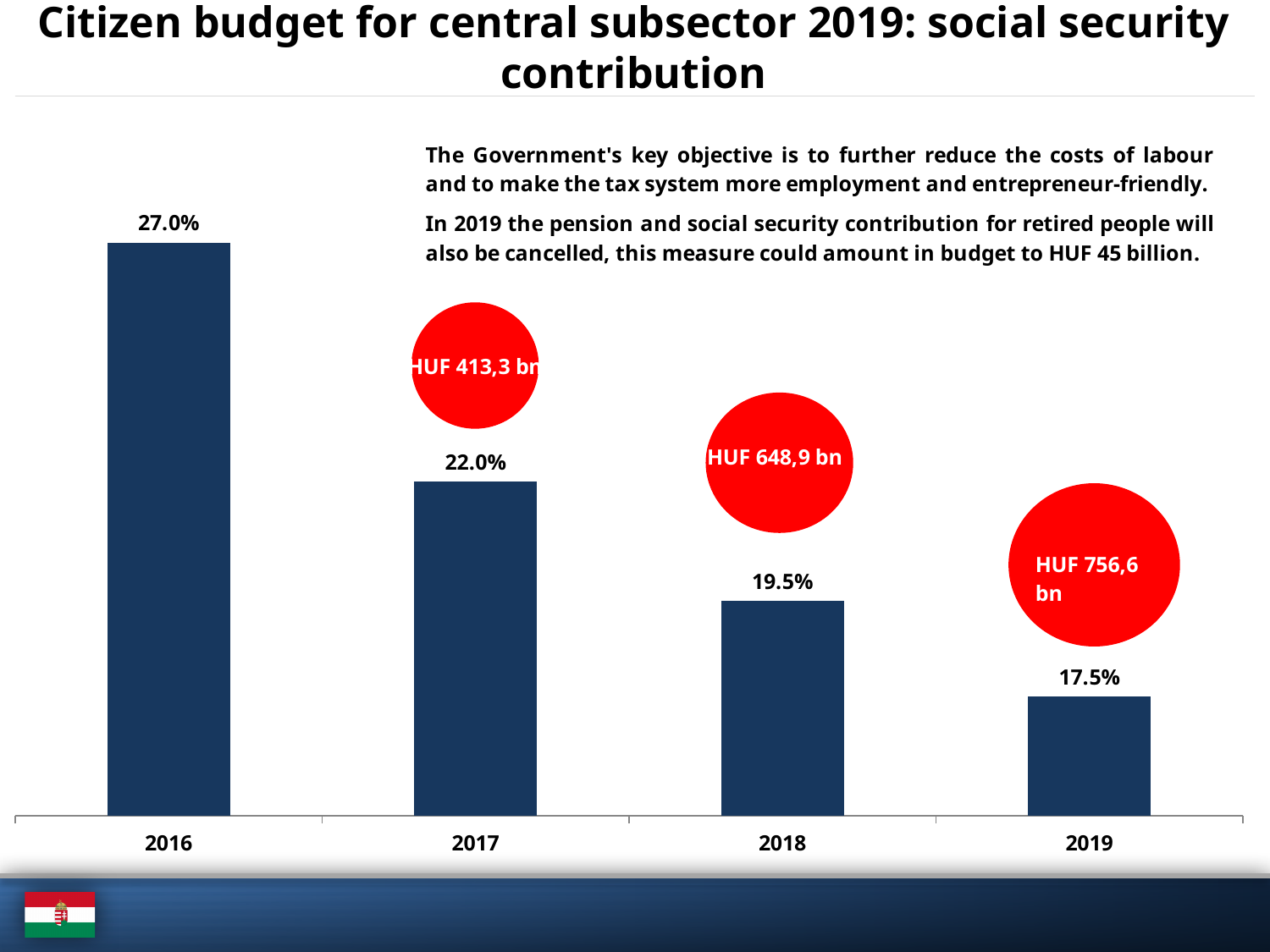
Which is larger, the value for 2017 or the value for 2018? 2017 How many years are shown on the x axis? 4 What amount is shown in the red circle above the 2018 bar? HUF 648,9 bn Do the values rise or fall from 2016 to 2019? fall Which year has the highest value? 2016 What is the difference between the values for 2016 and 2017? 5.0% Which year has the lowest value? 2019 What is the difference between the values for 2018 and 2019? 2.0% What is the value shown for 2019? 17.5% What is the value shown for 2018? 19.5% What kind of chart is shown on the slide? bar chart What is the value shown for 2016? 27.0%